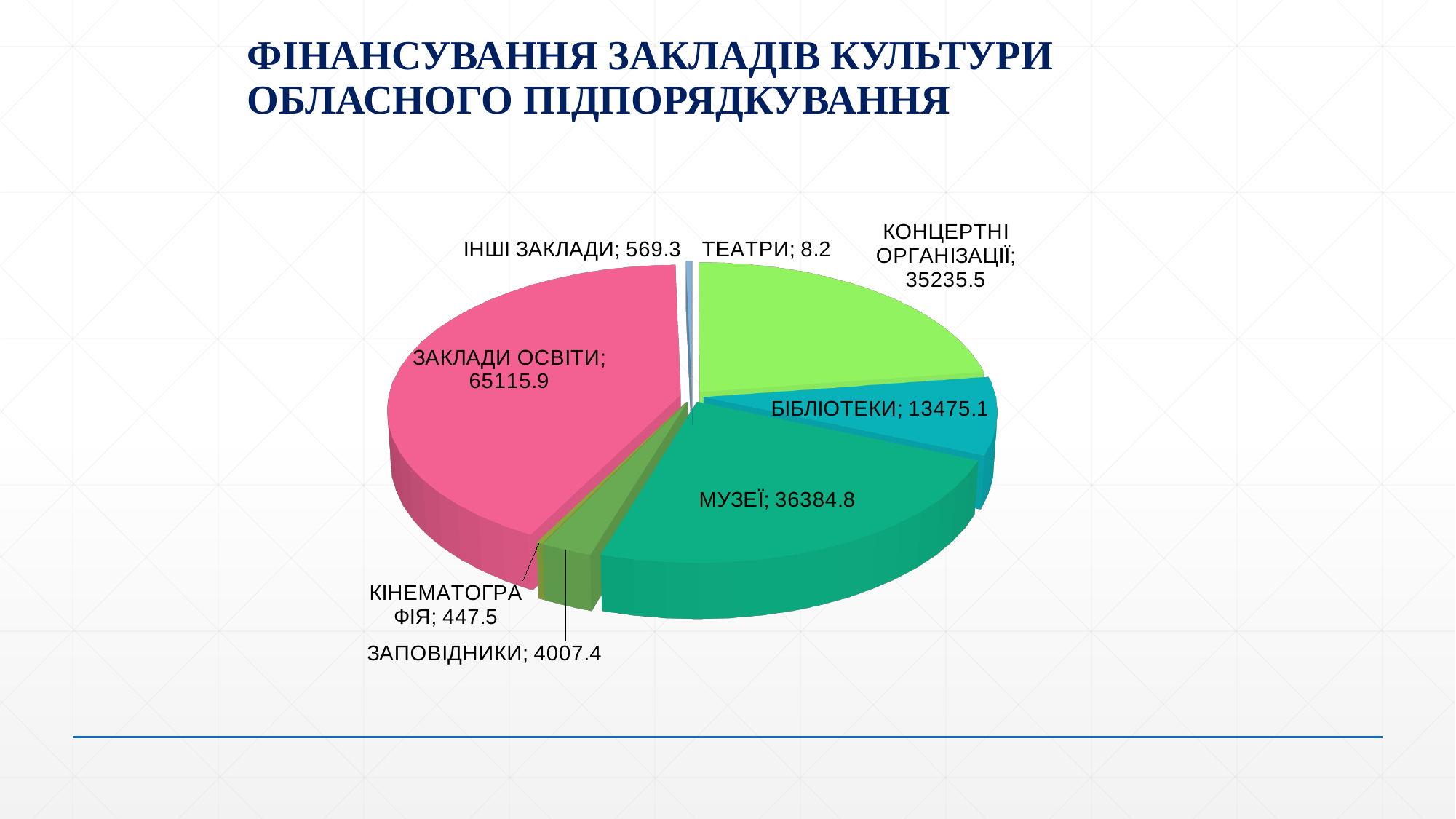
How many categories does the pie chart show? 8 What is the value for ТЕАТРИ? 8.2 Which category has the largest value? ЗАКЛАДИ ОСВІТИ What is the difference between the values for БІБЛІОТЕКИ and ЗАПОВІДНИКИ? 9467.7 What is the title of the chart on the slide? ФІНАНСУВАННЯ ЗАКЛАДІВ КУЛЬТУРИ ОБЛАСНОГО ПІДПОРЯДКУВАННЯ Which is larger, the value for ІНШІ ЗАКЛАДИ or the value for КІНЕМАТОГРАФІЯ? ІНШІ ЗАКЛАДИ What is the difference between the values for МУЗЕЇ and КОНЦЕРТНІ ОРГАНІЗАЦІЇ? 1149.3 What is the value for МУЗЕЇ? 36384.8 What is the value for ЗАКЛАДИ ОСВІТИ? 65115.9 What type of chart is shown on the slide? Pie chart Which category has the smallest value? ТЕАТРИ What is the value for БІБЛІОТЕКИ? 13475.1